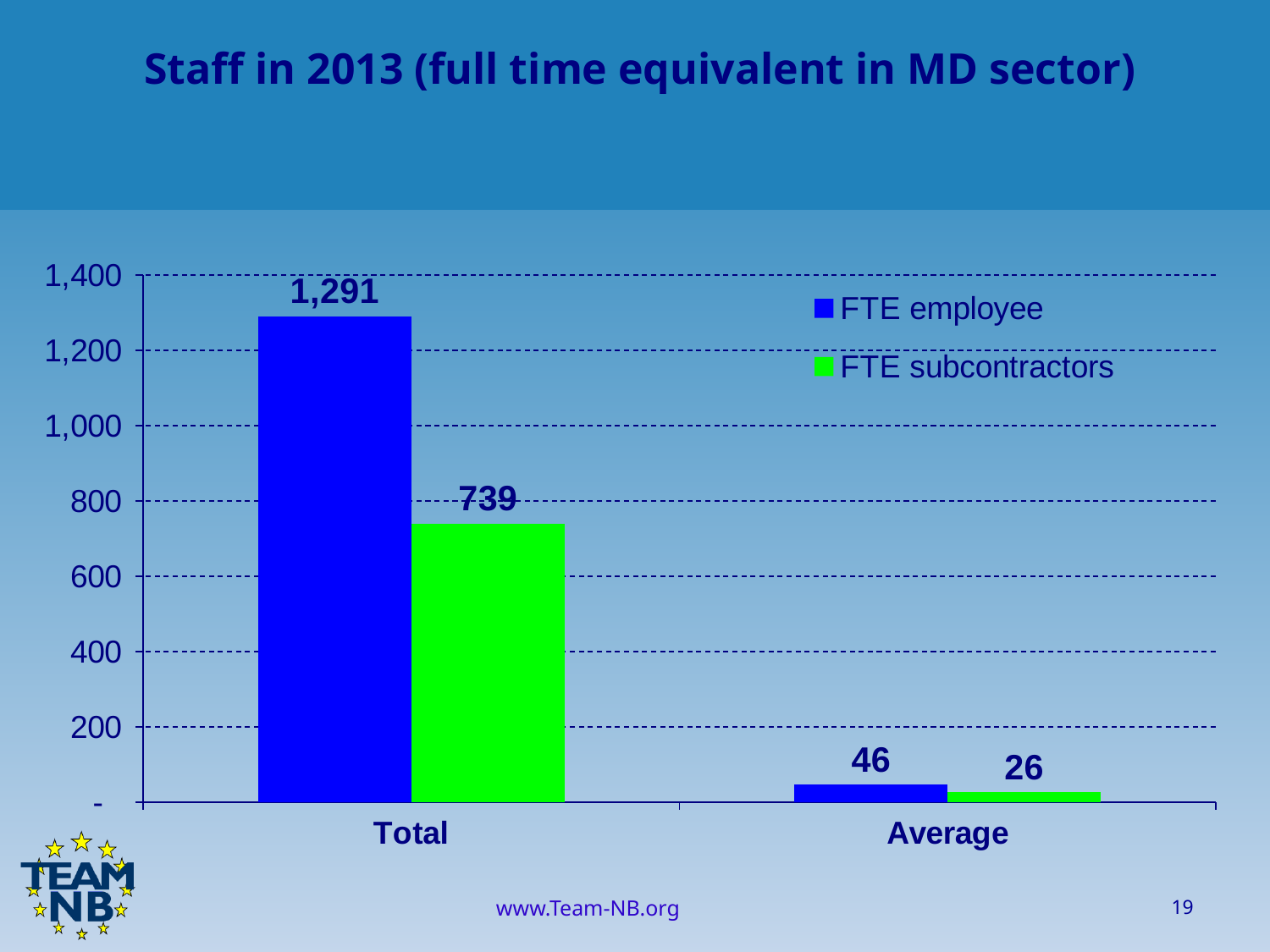
What is the FTE subcontractors value for Average? 26 How many series does the legend list? 2 How many categories are shown on the x axis? 2 What is the FTE employee value for Average? 46 What is the FTE employee value for Total? 1,291 Which category has the highest FTE employee value? Total For Total, which is larger: FTE employee or FTE subcontractors? FTE employee What kind of chart is shown on the slide? Bar chart What is the difference between FTE employee and FTE subcontractors for Average? 20 What is the FTE subcontractors value for Total? 739 Which category has the lowest FTE subcontractors value? Average What is the difference between FTE employee and FTE subcontractors for Total? 552